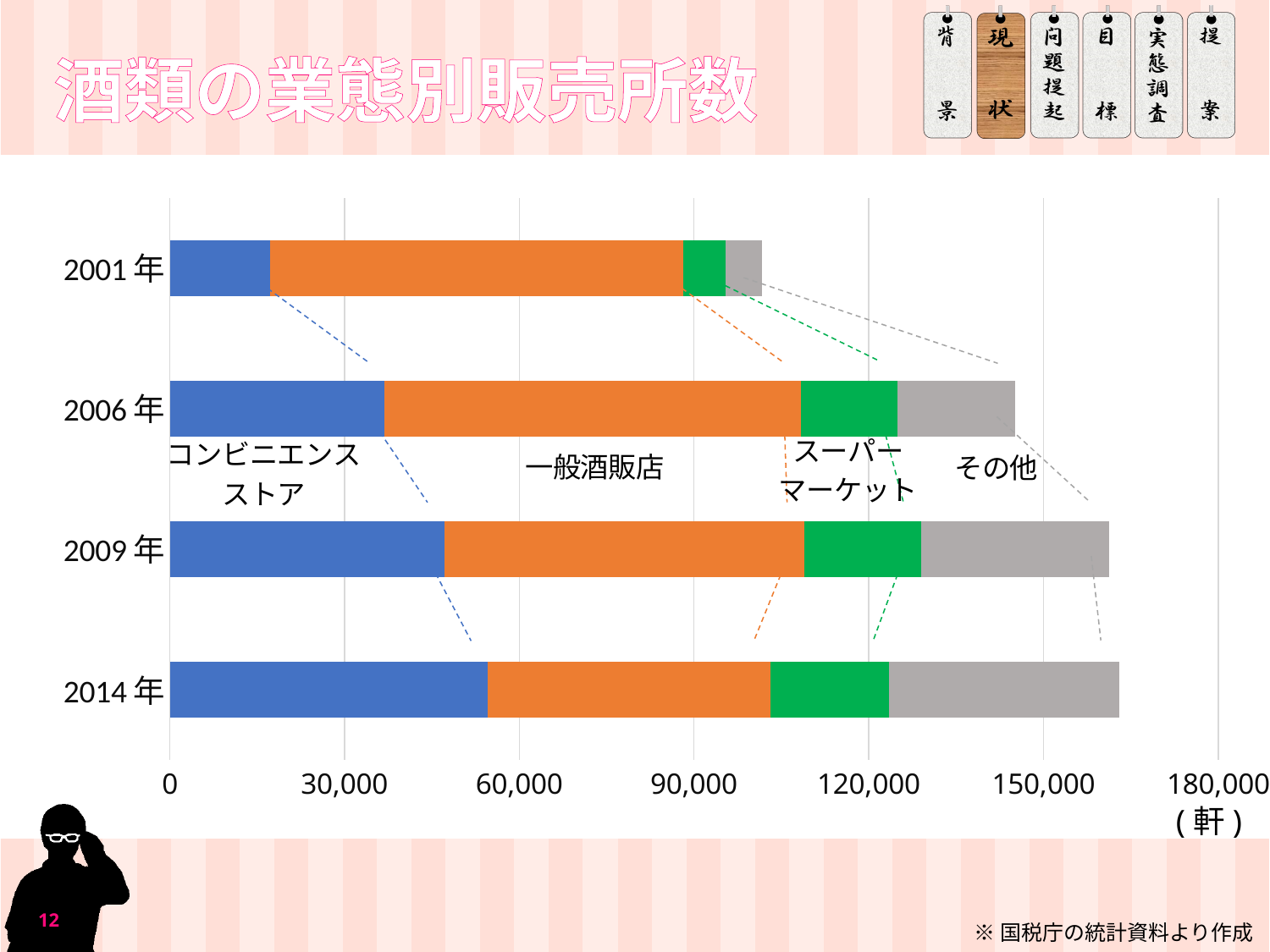
How many business-type segments make up each bar? 4 Is the total for 2006年 greater or less than 150,000? less Is the コンビニエンスストア segment larger in 2001年 or in 2014年? 2014年 Is the コンビニエンスストア value for 2001年 greater or less than 30,000? less What kind of chart is shown on the slide? stacked bar chart Is the total for 2001年 greater or less than 90,000? greater Does the total number of outlets rise or fall from 2001年 to 2014年? rise Is the 一般酒販店 segment larger in 2001年 or in 2014年? 2001年 What is the title of the chart on the slide? 酒類の業態別販売所数 How many years (categories) are plotted on the chart? 4 Which year has the shortest total bar? 2001年